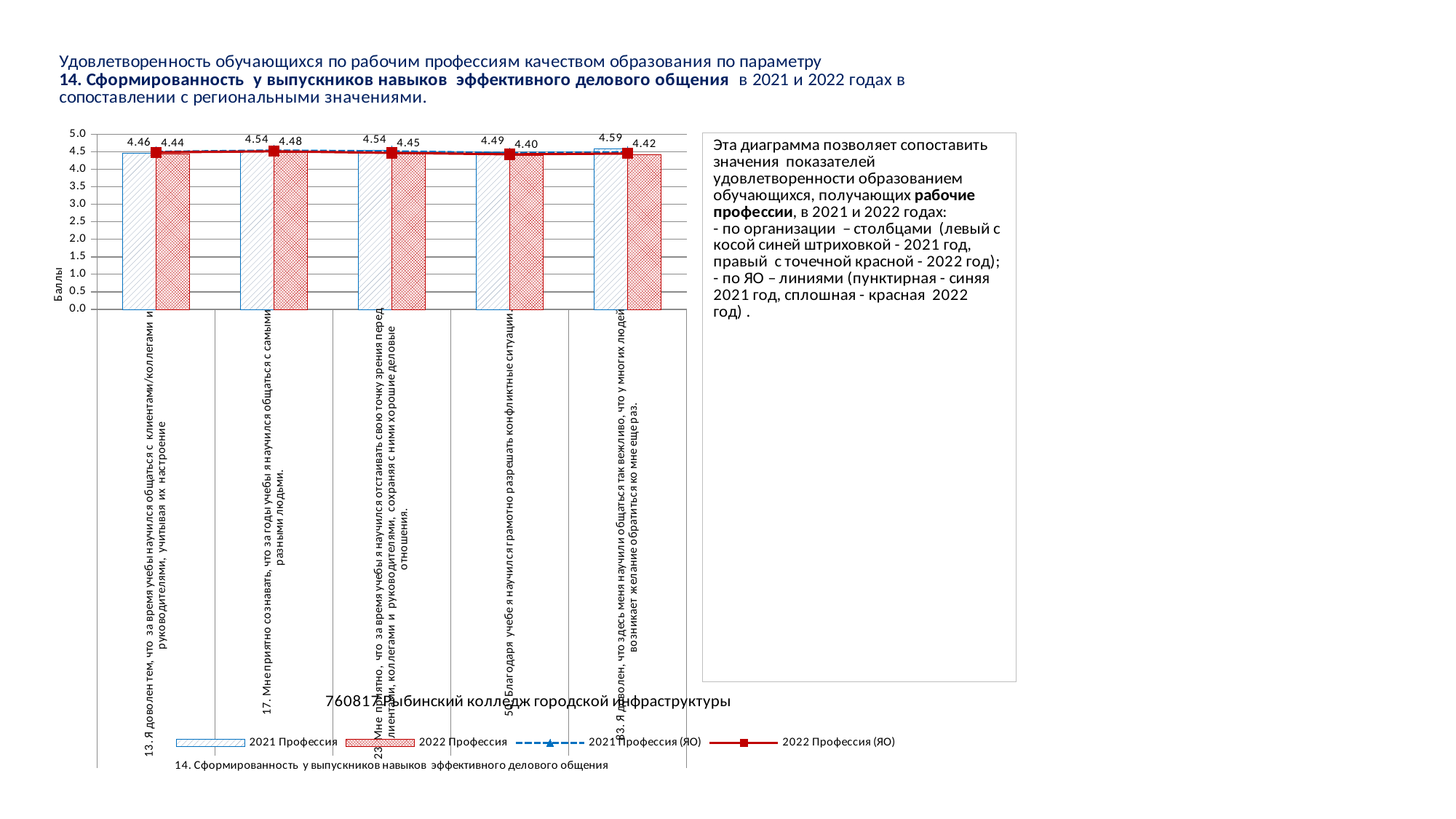
How many categories (questions) are shown on the x axis of the chart? 5 Which category has the highest 2021 Профессия value? 83 (4.59) What is the difference between the 2021 Профессия and 2022 Профессия values for category 83? 0.17 What is the value of the 2022 Профессия bar for category 83 (Я доволен, что здесь меня научили общаться так вежливо...)? 4.42 Which legend entry is shown as a dashed blue line? 2021 Профессия (ЯО) Which category has the lowest 2022 Профессия value? 50 (4.40) What is the label of the vertical axis of the chart? Баллы Is the 2022 Профессия value for category 13 greater or less than 4.0? greater How many series does the chart legend list? 4 For category 17, which is larger: the 2021 Профессия value or the 2022 Профессия value? 2021 Профессия (4.54) What kind of chart is shown on the slide? combined bar and line chart What is the value of the 2021 Профессия bar for category 13 (Я доволен тем, что за время учебы научился общаться с клиентами/коллегами и руководителями)? 4.46